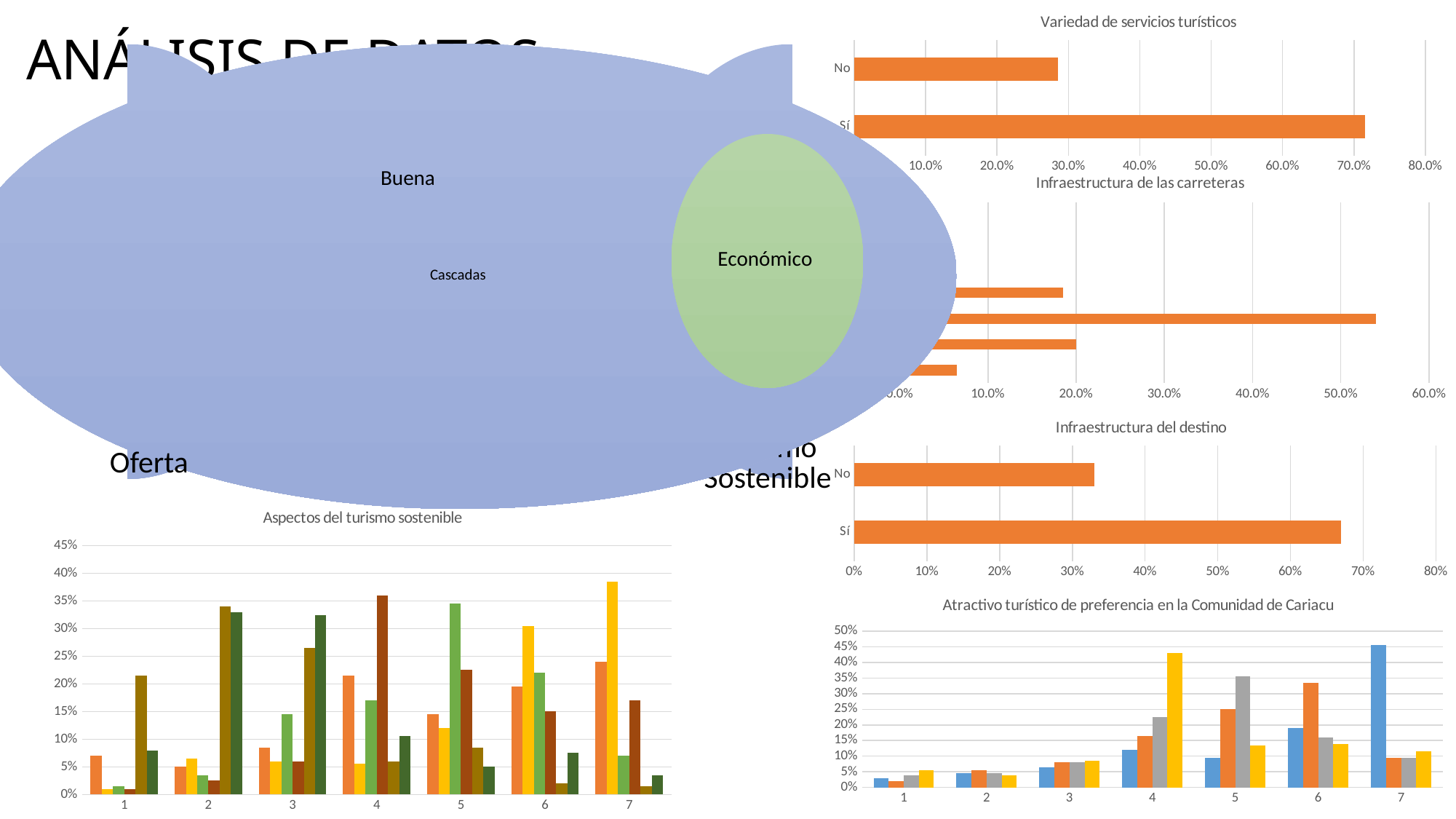
In the 'Variedad de servicios turísticos' chart, is the value for No greater or less than 20.0%? greater What kind of chart is 'Infraestructura del destino'? bar chart In the 'Infraestructura de las carreteras' chart, is the longest bar greater or less than 50.0%? greater In the 'Atractivo turístico de preferencia en la Comunidad de Cariacu' chart, is the tallest bar in category 7 greater or less than 40%? greater How many categories are on the x axis of the 'Aspectos del turismo sostenible' chart? 7 In the 'Variedad de servicios turísticos' chart, which category has the longer bar, Sí or No? Sí In the 'Atractivo turístico de preferencia en la Comunidad de Cariacu' chart, how many bars are in each category group? 4 How many categories are shown in the 'Variedad de servicios turísticos' chart? 2 In the 'Infraestructura del destino' chart, which category has the highest value? Sí